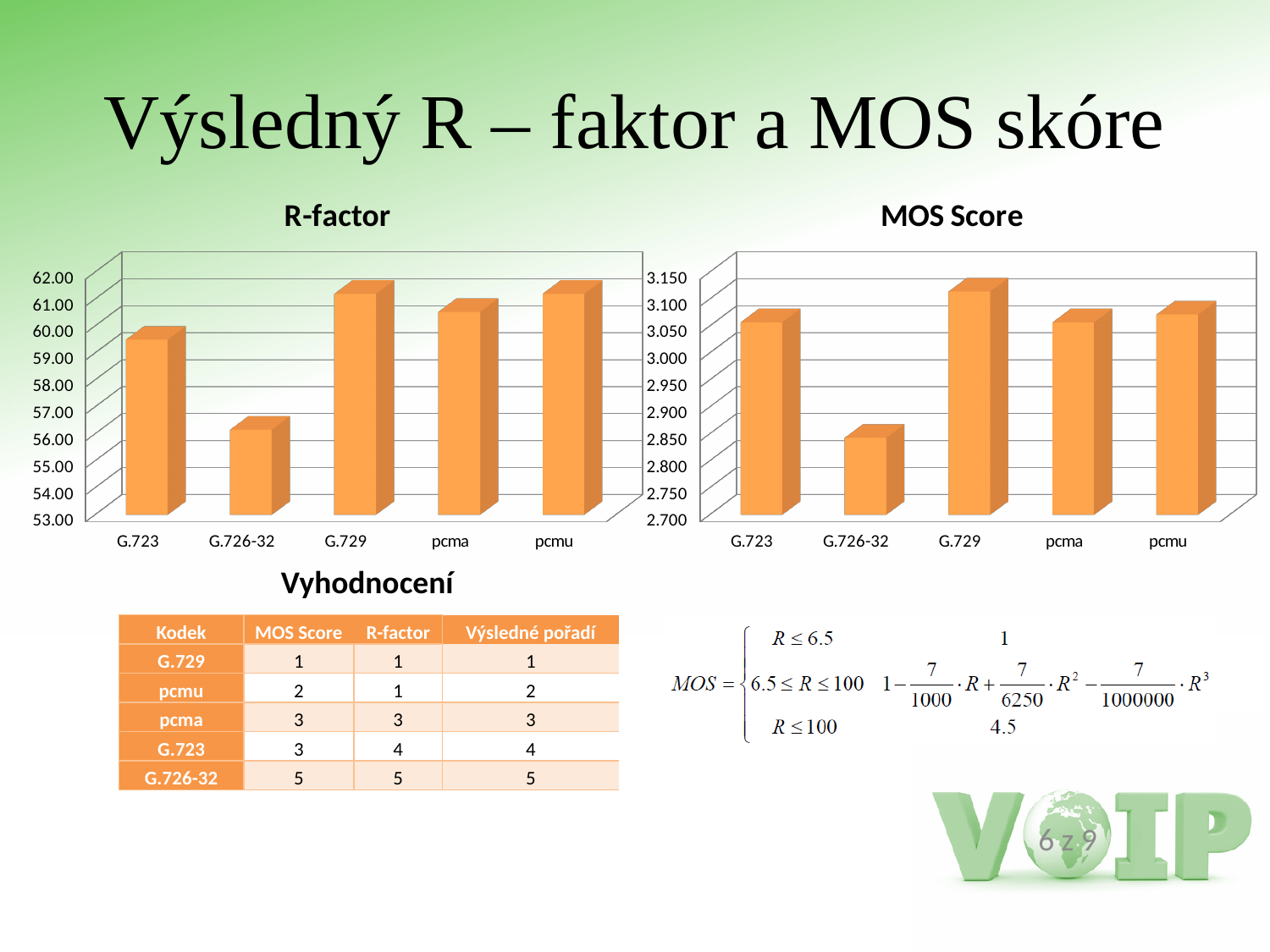
On the R-factor chart, which is larger, the value for G.729 or the value for G.726-32? G.729 On the R-factor chart, which codec has the lowest value? G.726-32 On the R-factor chart, is the value for G.729 greater or less than 60.00? greater On the MOS Score chart, which codec has the lowest value? G.726-32 What kind of chart is the MOS Score chart? bar chart On the MOS Score chart, which is larger, the value for pcma or the value for G.726-32? pcma On the MOS Score chart, is the value for G.726-32 greater or less than 2.900? less On the MOS Score chart, is the value for G.729 greater or less than 3.000? greater How many codecs are shown on the R-factor chart? 5 What is the title of the chart on the left side of the slide? R-factor On the MOS Score chart, which codec has the highest value? G.729